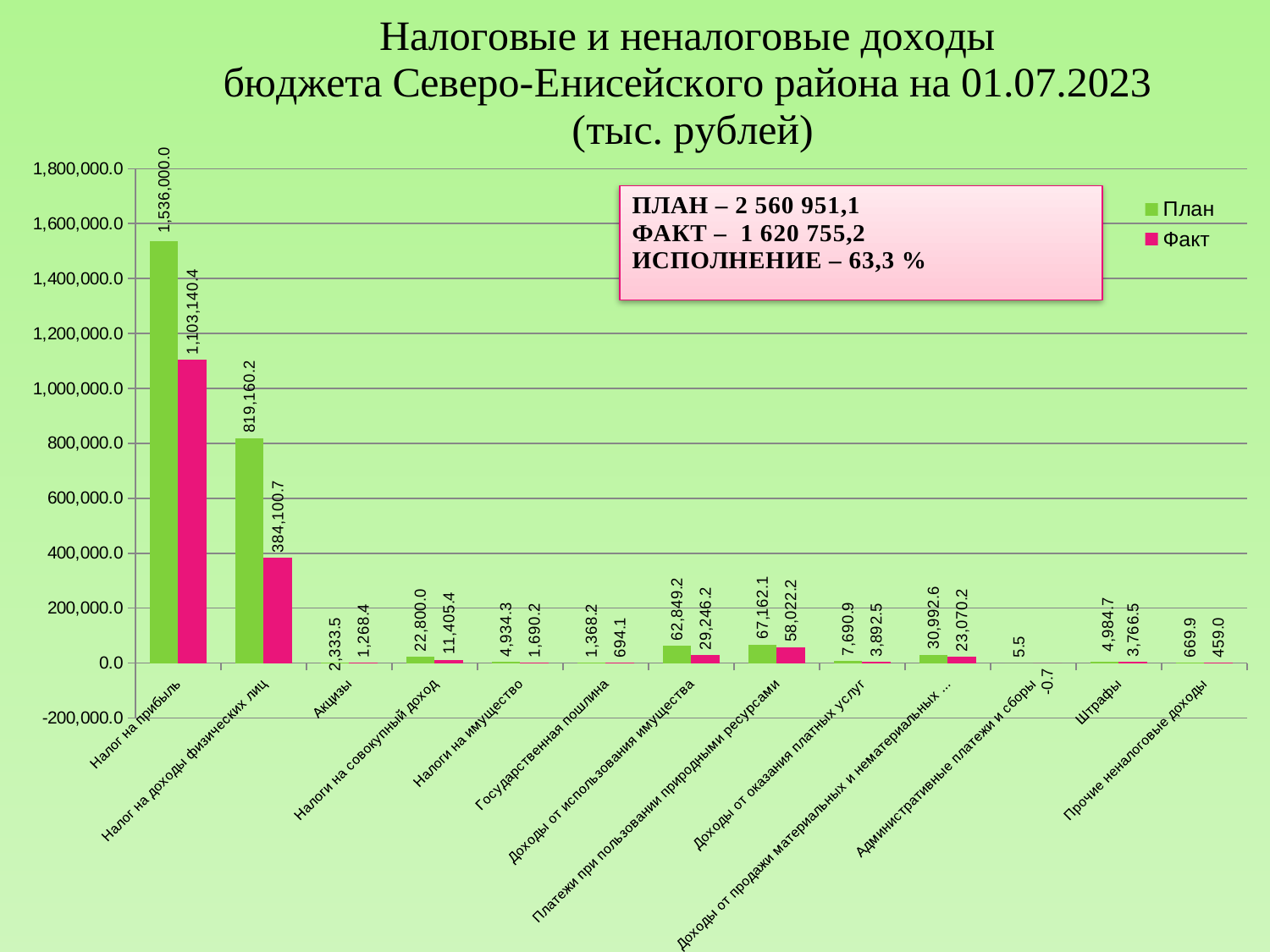
What is the План value for Штрафы? 4,984.7 What is the Факт value for Налог на доходы физических лиц? 384,100.7 What is the План value for Налог на прибыль? 1,536,000.0 How many series does the legend list? 2 What is the difference between the План and Факт values for Налог на прибыль? 432,859.6 How many categories are shown on the x axis? 13 What kind of chart is shown on the slide? Bar chart Which category has the lowest Факт value? Административные платежи и сборы Which category has the highest Факт value? Налог на прибыль Which is larger: the Факт value for Доходы от использования имущества or the Факт value for Платежи при пользовании природными ресурсами? Платежи при пользовании природными ресурсами What is the Факт value for Платежи при пользовании природными ресурсами? 58,022.2 What is the difference between the План and Факт values for Государственная пошлина? 674.1